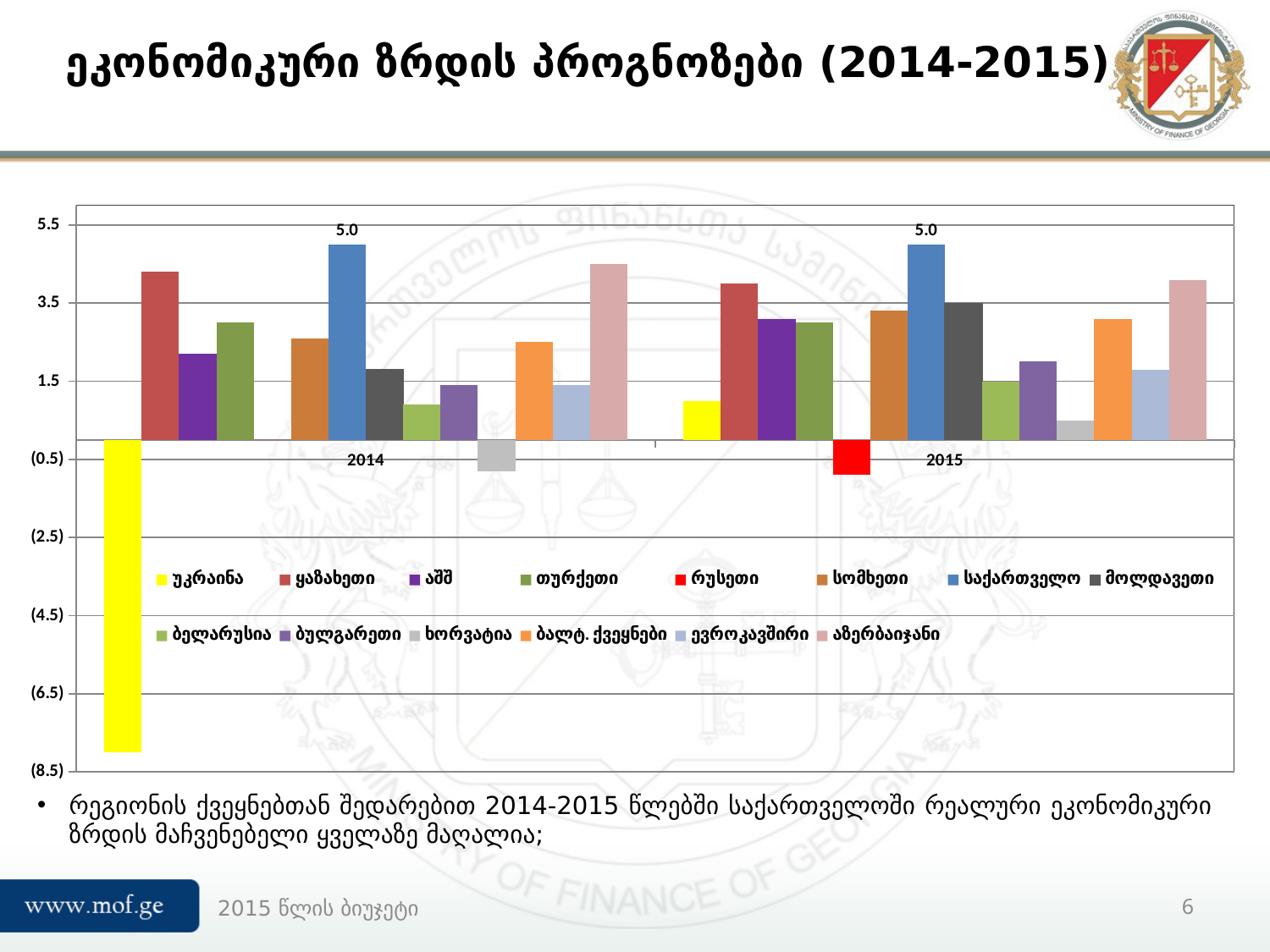
Which country has the highest bar in the 2014 group? საქართველო Which country has the lowest bar in the 2014 group? უკრაინა How many year groups are shown on the x axis? 2 Which country has the lowest bar in the 2015 group? რუსეთი Which is larger: the value for მოლდავეთი in 2014 or in 2015? 2015 What kind of chart is shown on the slide? bar chart How many series does the legend list? 14 What colour represents საქართველო in the legend? blue What value is labelled for საქართველო in 2015? 5.0 Is the value for აზერბაიჯანი in 2014 greater or less than 3.5? greater Which is larger: the value for უკრაინა in 2014 or in 2015? 2015 What value is labelled for საქართველო in 2014? 5.0